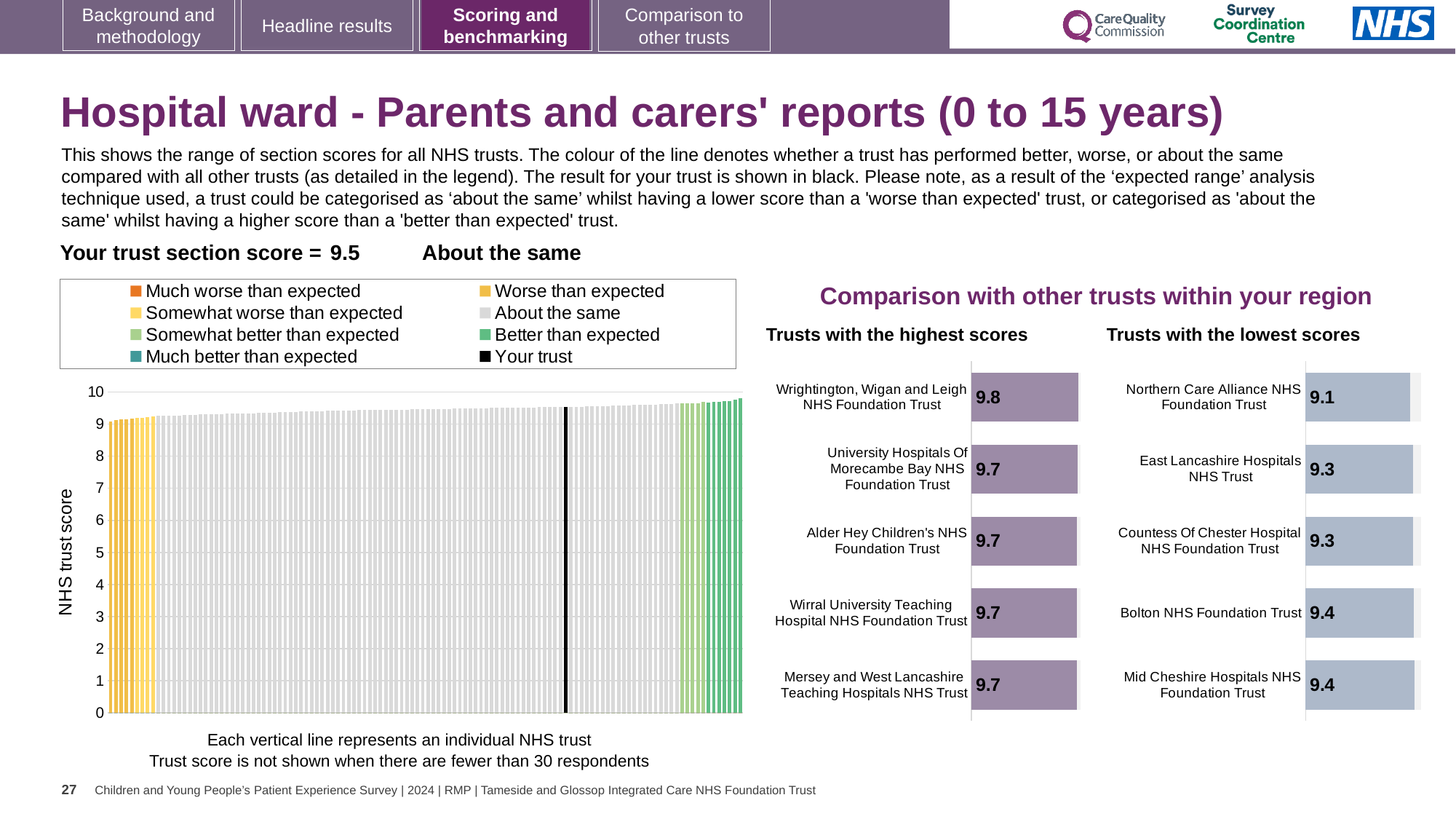
In the 'Trusts with the highest scores' chart, which trust has the highest score? Wrightington, Wigan and Leigh NHS Foundation Trust How many entries does the legend of the left-hand chart list? 8 In the 'Trusts with the lowest scores' chart, what is the score for Northern Care Alliance NHS Foundation Trust? 9.1 In the 'Trusts with the highest scores' chart, what is the score for Wrightington, Wigan and Leigh NHS Foundation Trust? 9.8 In the left-hand chart, is the value of the black 'Your trust' bar greater or less than 8? greater In the 'Trusts with the highest scores' chart, what is the difference between the scores of Wrightington, Wigan and Leigh NHS Foundation Trust and Alder Hey Children's NHS Foundation Trust? 0.1 In the 'Trusts with the lowest scores' chart, what is the score for Bolton NHS Foundation Trust? 9.4 What kind of chart is the large chart on the left showing NHS trust scores? Bar chart In the 'Trusts with the lowest scores' chart, which has the larger score: East Lancashire Hospitals NHS Trust or Bolton NHS Foundation Trust? Bolton NHS Foundation Trust In the 'Trusts with the lowest scores' chart, what is the difference between the scores of Mid Cheshire Hospitals NHS Foundation Trust and Northern Care Alliance NHS Foundation Trust? 0.3 In the 'Trusts with the lowest scores' chart, which trust has the lowest score? Northern Care Alliance NHS Foundation Trust In the 'Trusts with the highest scores' chart, how many trusts are shown? 5